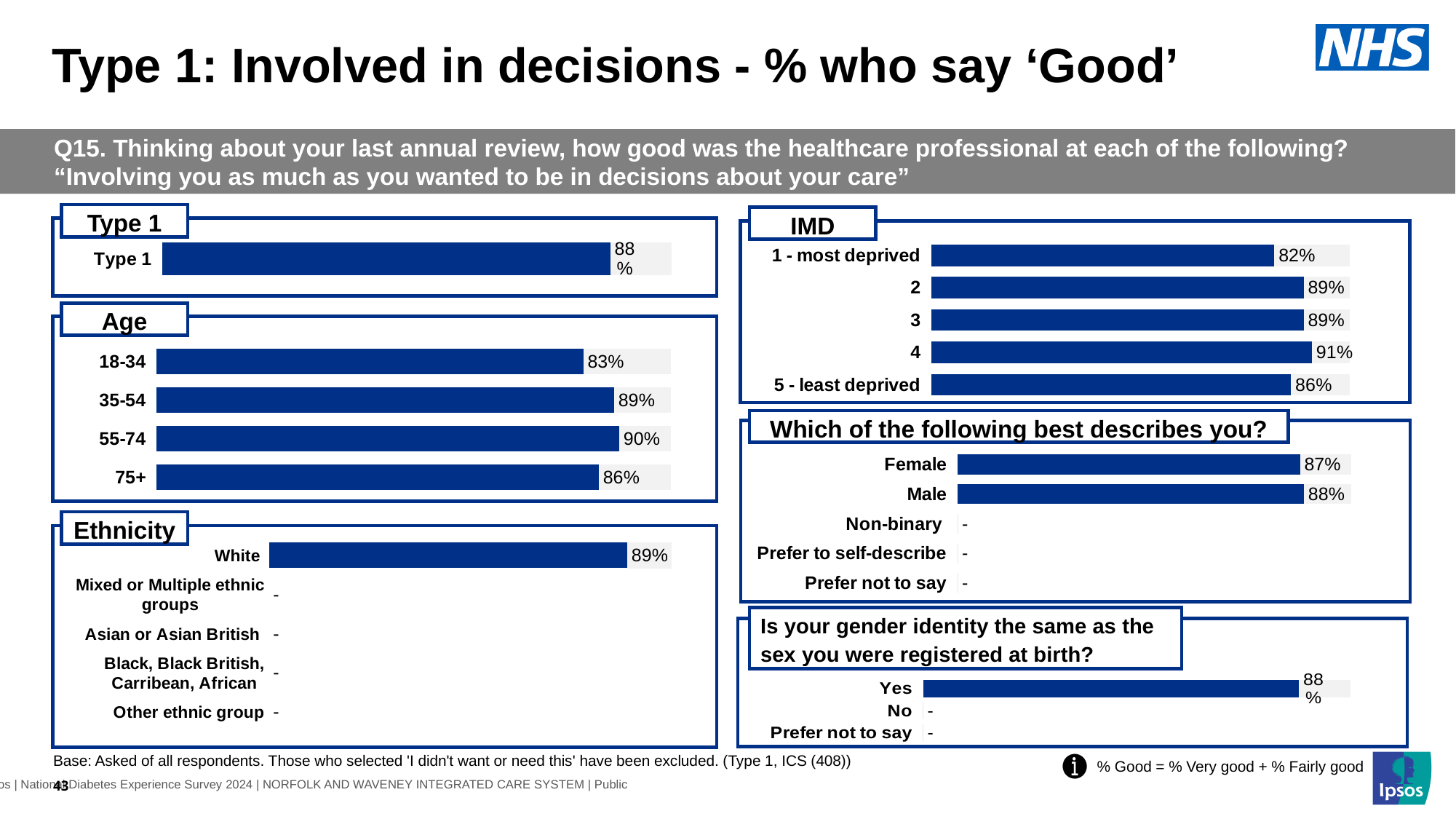
In the Age chart, what is the difference between the 55-74 and 18-34 values? 7 percentage points In the 'Is your gender identity the same as the sex you were registered at birth?' chart, what is the value for Yes? 88% In the 'Which of the following best describes you?' chart, what is the difference between the Male and Female values? 1 percentage point In the IMD chart, which category has the lowest value? 1 - most deprived In the IMD chart, which is larger: the value for '1 - most deprived' or '5 - least deprived'? 5 - least deprived In the IMD chart, what is the value for '4'? 91% In the IMD chart, how many categories are shown? 5 In the Age chart, which age group has the lowest value? 18-34 In the Age chart, which age group has the highest value? 55-74 In the Age chart, what is the value for the 18-34 age group? 83% In the Ethnicity chart, what is the value for White? 89% In the Type 1 chart, what percentage of Type 1 respondents say 'Good'? 88%